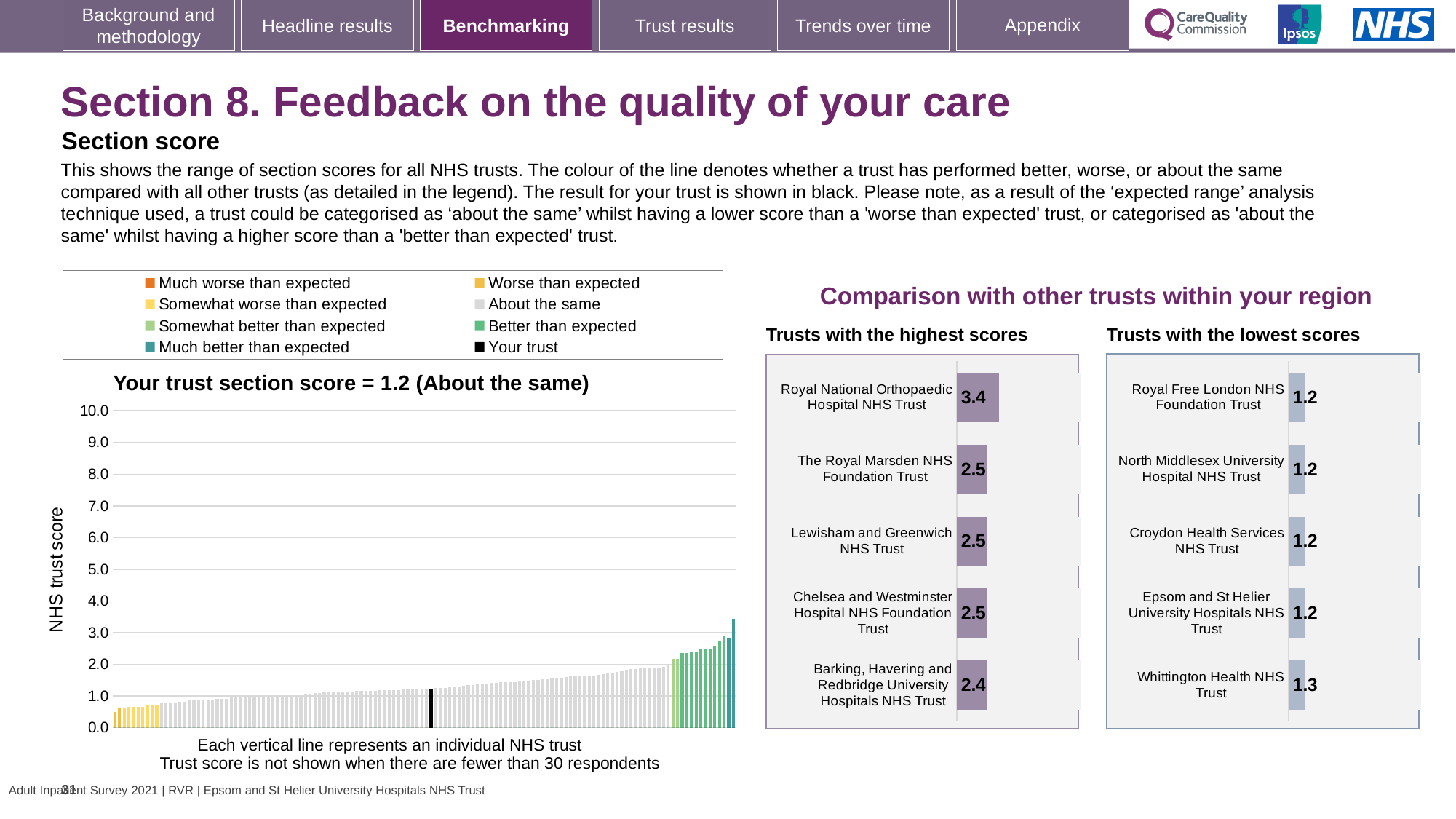
On the 'Your trust section score' chart, what is the section score for your trust? 1.2 How many trusts are shown on the 'Trusts with the lowest scores' chart? 5 What kind of chart is the 'Your trust section score' chart? Bar chart On the 'Trusts with the highest scores' chart, which trust has the highest score? Royal National Orthopaedic Hospital NHS Trust On the 'Trusts with the highest scores' chart, what is the difference between the scores of Royal National Orthopaedic Hospital NHS Trust and Barking, Havering and Redbridge University Hospitals NHS Trust? 1.0 How many entries does the legend above the 'Your trust section score' chart list? 8 On the 'Your trust section score' chart, which category does your trust fall into? About the same On the 'Your trust section score' chart, do the trust scores rise or fall from left to right? Rise On the 'Your trust section score' chart, is the value of the tallest bar greater or less than 3.0? greater On the 'Trusts with the lowest scores' chart, what is the difference between the scores of Whittington Health NHS Trust and Croydon Health Services NHS Trust? 0.1 On the 'Trusts with the highest scores' chart, what is the score for Royal National Orthopaedic Hospital NHS Trust? 3.4 On the 'Trusts with the lowest scores' chart, what is the score for Whittington Health NHS Trust? 1.3